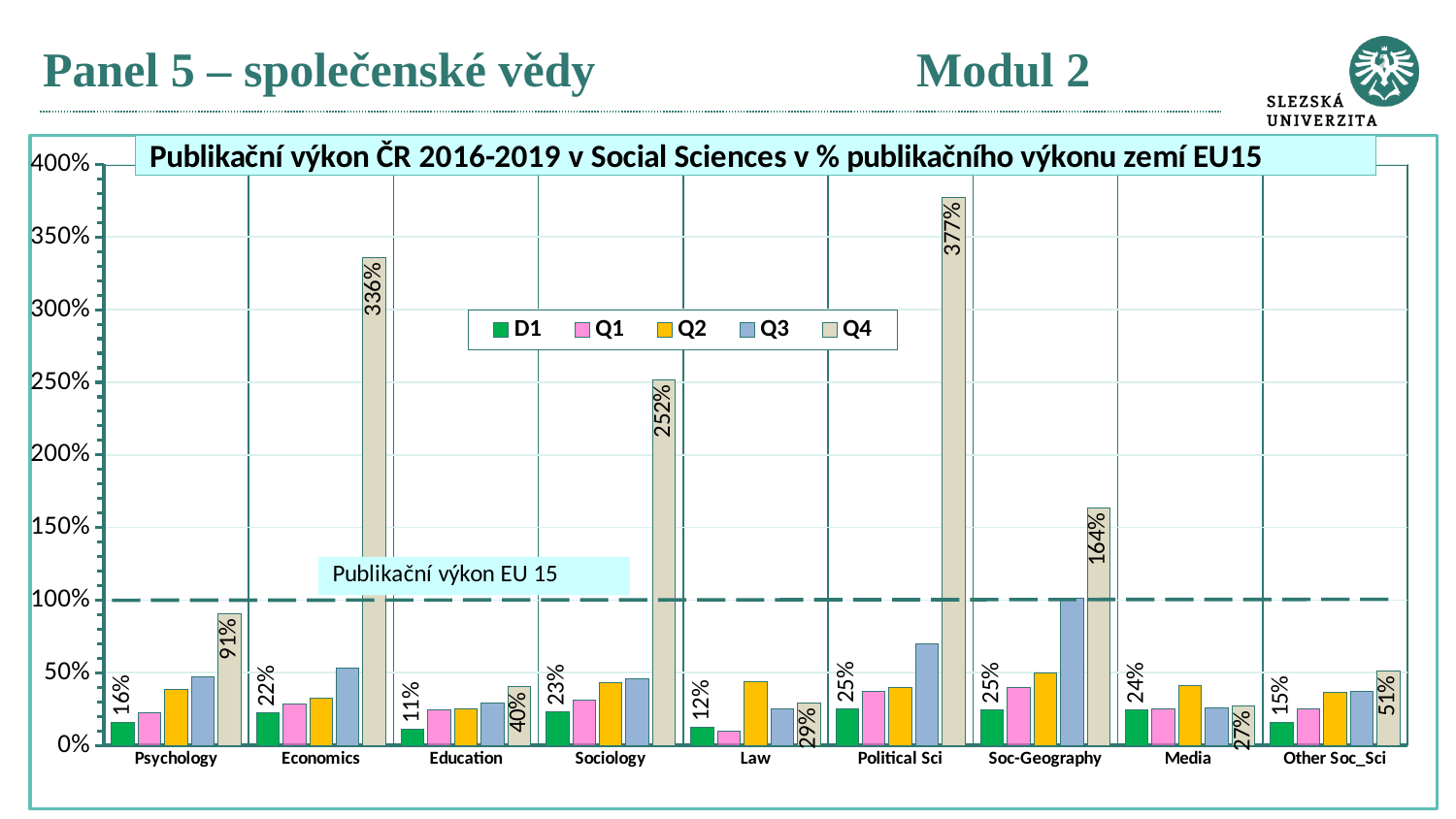
What is the Q4 value for Law? 29% How many series does the legend list? 5 Which is larger, the Q4 value for Sociology or the Q4 value for Soc-Geography? Sociology Is the Q3 value for Soc-Geography greater or less than 50%? greater How many categories are shown on the x axis? 9 What is the D1 value for Education? 11% What is the difference between the Q4 values for Political Sci and Economics? 41% What is the Q4 value for Economics? 336% Which category has the lowest D1 value? Education What kind of chart is shown on the slide? bar chart What is the title of the chart? Publikační výkon ČR 2016-2019 v Social Sciences v % publikačního výkonu zemí EU15 Which category has the highest Q4 value? Political Sci